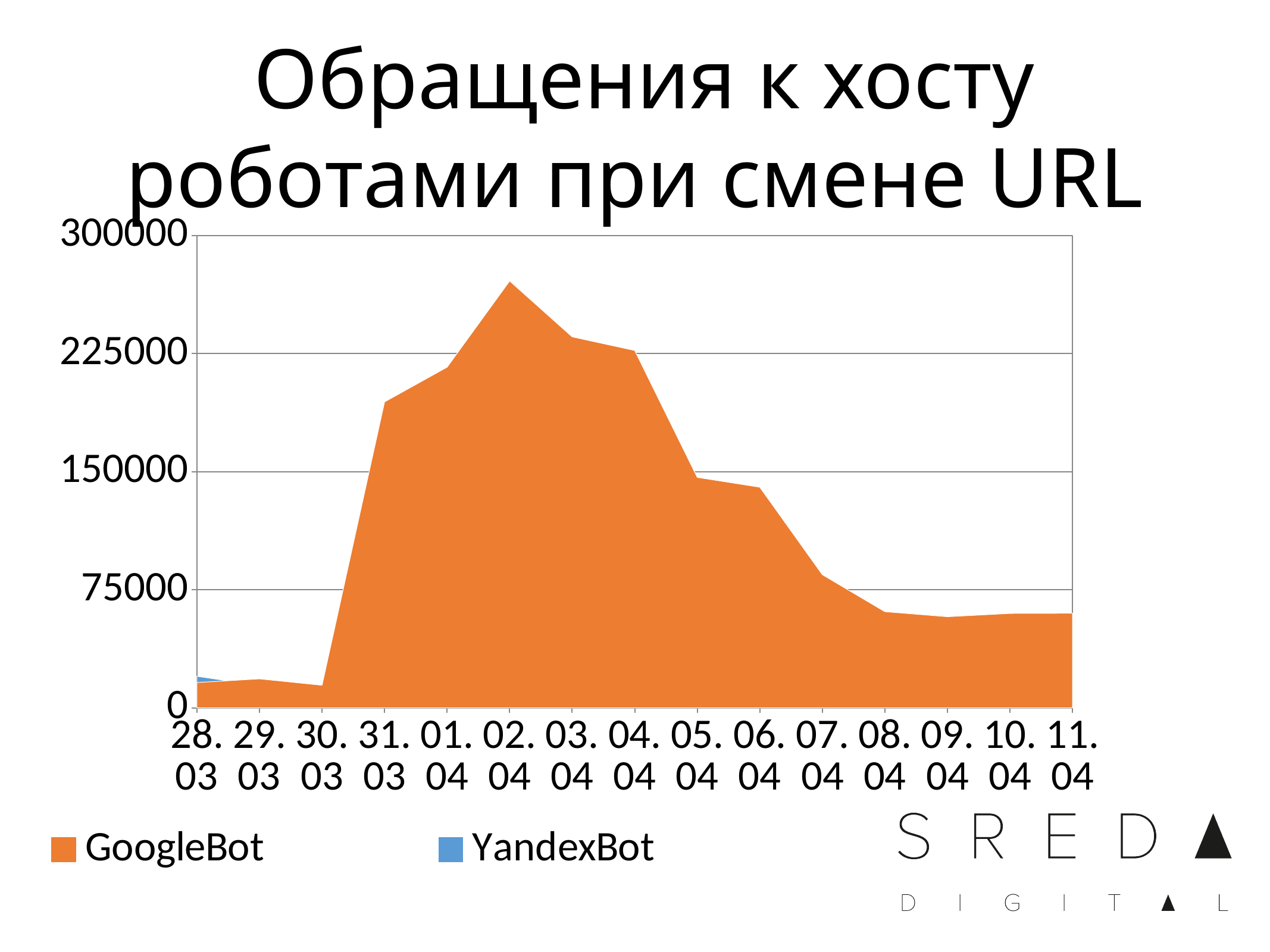
On which date does GoogleBot reach its highest value? 02.04 Is the GoogleBot value on 28.03 greater or less than 75000? less What kind of chart is shown on the slide? area chart What is the title of the chart? Обращения к хосту роботами при смене URL Do the GoogleBot values rise or fall from 02.04 to 08.04? fall Is the GoogleBot value on 11.04 greater or less than 75000? less Is the GoogleBot value on 31.03 greater or less than 150000? greater Which series is shown in orange? GoogleBot How many series does the legend list? 2 Which is larger, the GoogleBot value on 02.04 or on 28.03? 02.04 How many dates are shown along the x axis? 15